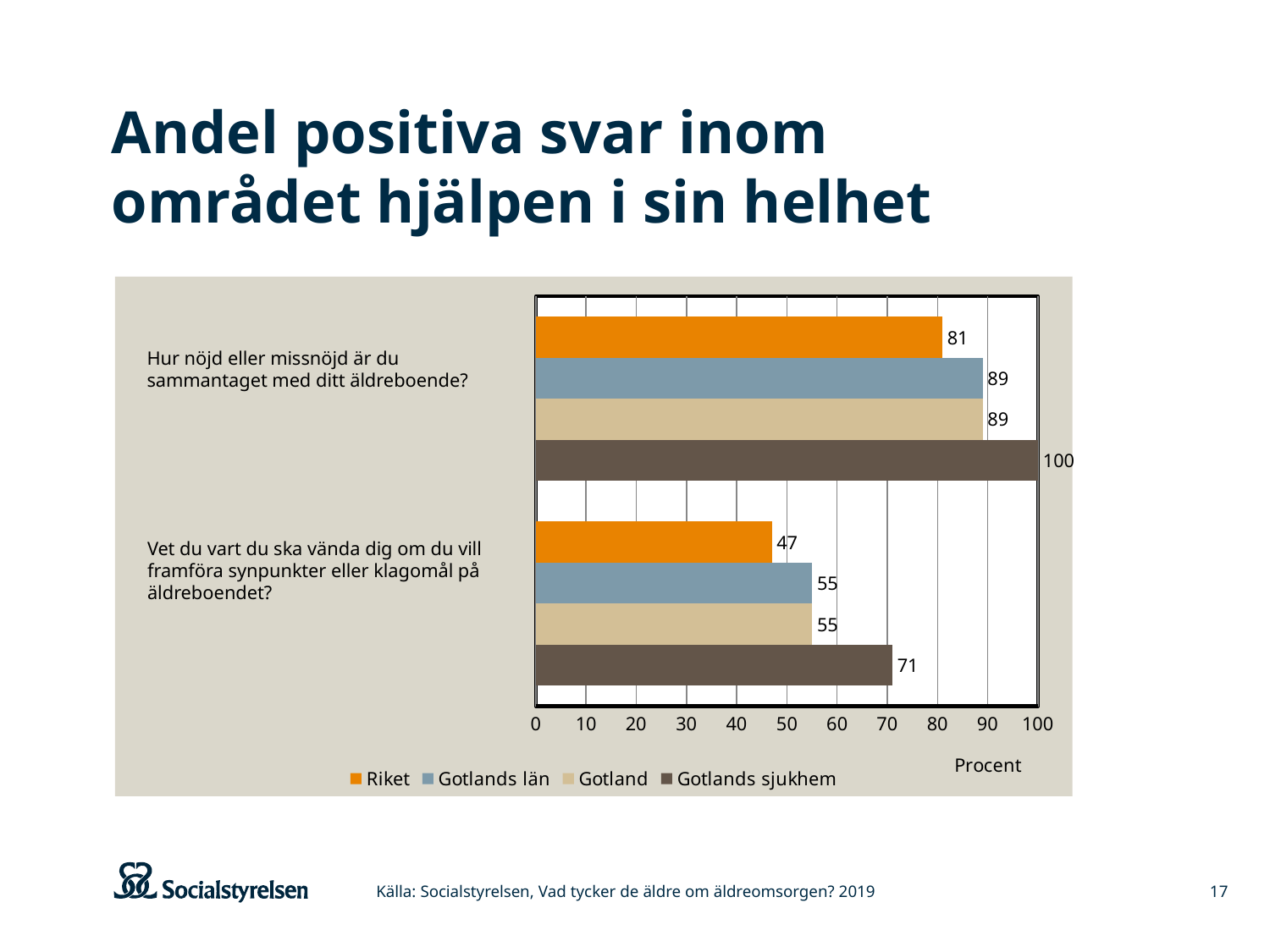
What kind of chart is shown on the slide? Bar chart How many series does the legend list? 4 How many question categories are shown on the chart? 2 Which is larger: the Riket value for 'Hur nöjd eller missnöjd är du sammantaget med ditt äldreboende?' or the Riket value for 'Vet du vart du ska vända dig om du vill framföra synpunkter eller klagomål på äldreboendet?' Hur nöjd eller missnöjd är du sammantaget med ditt äldreboende? What is the value for Riket for the question 'Hur nöjd eller missnöjd är du sammantaget med ditt äldreboende?' 81 Which series has the highest value for the question 'Hur nöjd eller missnöjd är du sammantaget med ditt äldreboende?' Gotlands sjukhem What unit label is shown on the x axis of the chart? Procent What is the difference between Gotlands sjukhem and Riket for the question 'Hur nöjd eller missnöjd är du sammantaget med ditt äldreboende?' 19 Which series has the lowest value for the question 'Vet du vart du ska vända dig om du vill framföra synpunkter eller klagomål på äldreboendet?' Riket What is the value for Gotlands sjukhem for the question 'Vet du vart du ska vända dig om du vill framföra synpunkter eller klagomål på äldreboendet?' 71 What is the value for Gotlands län for the question 'Vet du vart du ska vända dig om du vill framföra synpunkter eller klagomål på äldreboendet?' 55 What is the difference between Gotlands sjukhem and Gotland for the question 'Vet du vart du ska vända dig om du vill framföra synpunkter eller klagomål på äldreboendet?' 16